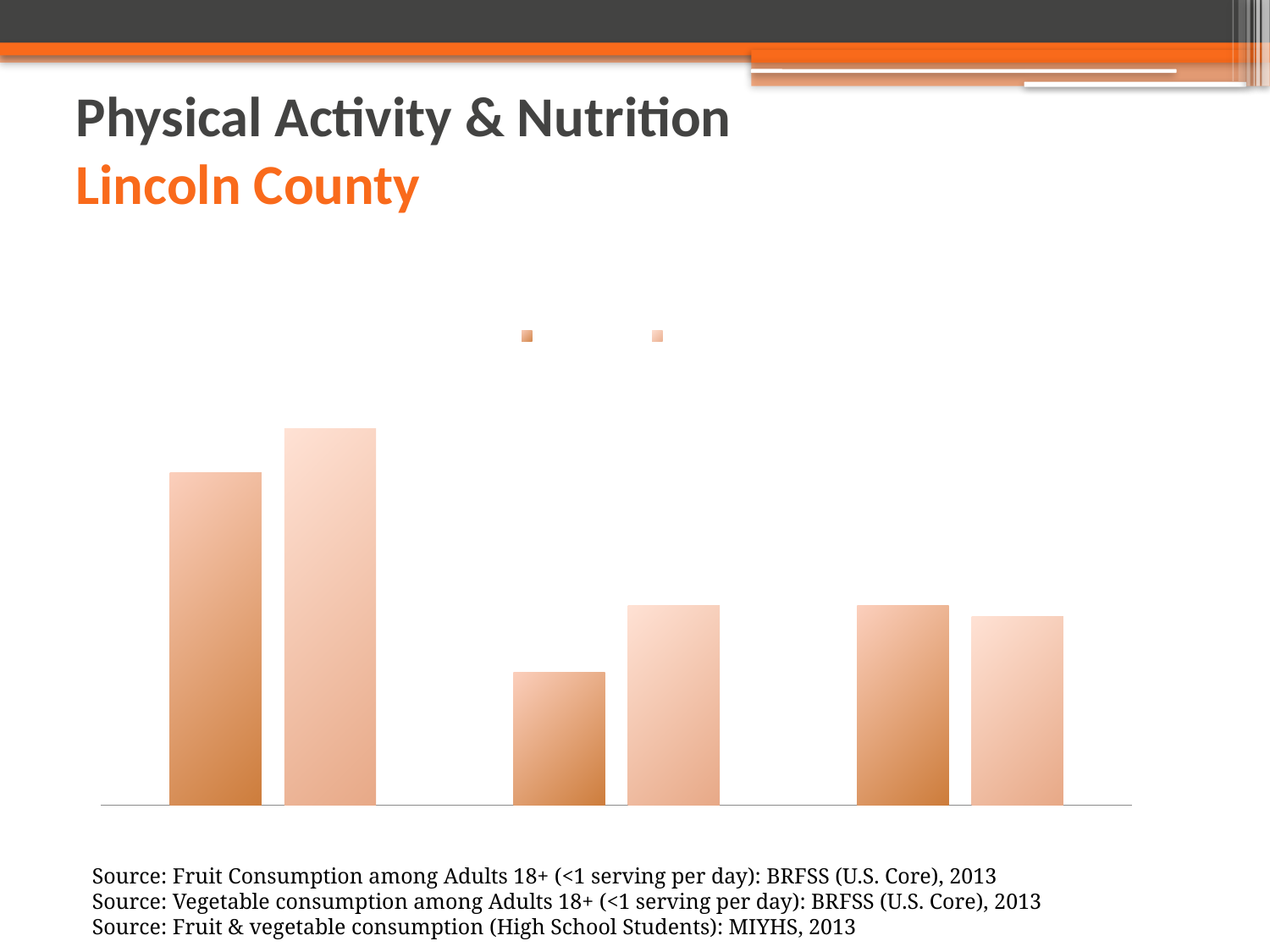
In the rightmost group of bars, is the darker orange bar or the lighter orange bar taller? darker orange bar What colour family are the bars in the chart? orange In the middle group of bars, is the darker orange bar or the lighter orange bar taller? lighter orange bar Which single bar is the shortest in the chart: the darker or lighter bar of the middle group? darker bar of the middle group Are the bars in the chart vertical or horizontal? vertical How many series does the chart's legend list? 2 Which group of bars is the tallest overall: the leftmost, middle, or rightmost group? leftmost In the leftmost group of bars, is the darker orange bar or the lighter orange bar taller? lighter orange bar What kind of chart is shown on the slide? bar chart How many groups of bars are plotted in the chart? 3 How many bars in total are plotted in the chart? 6